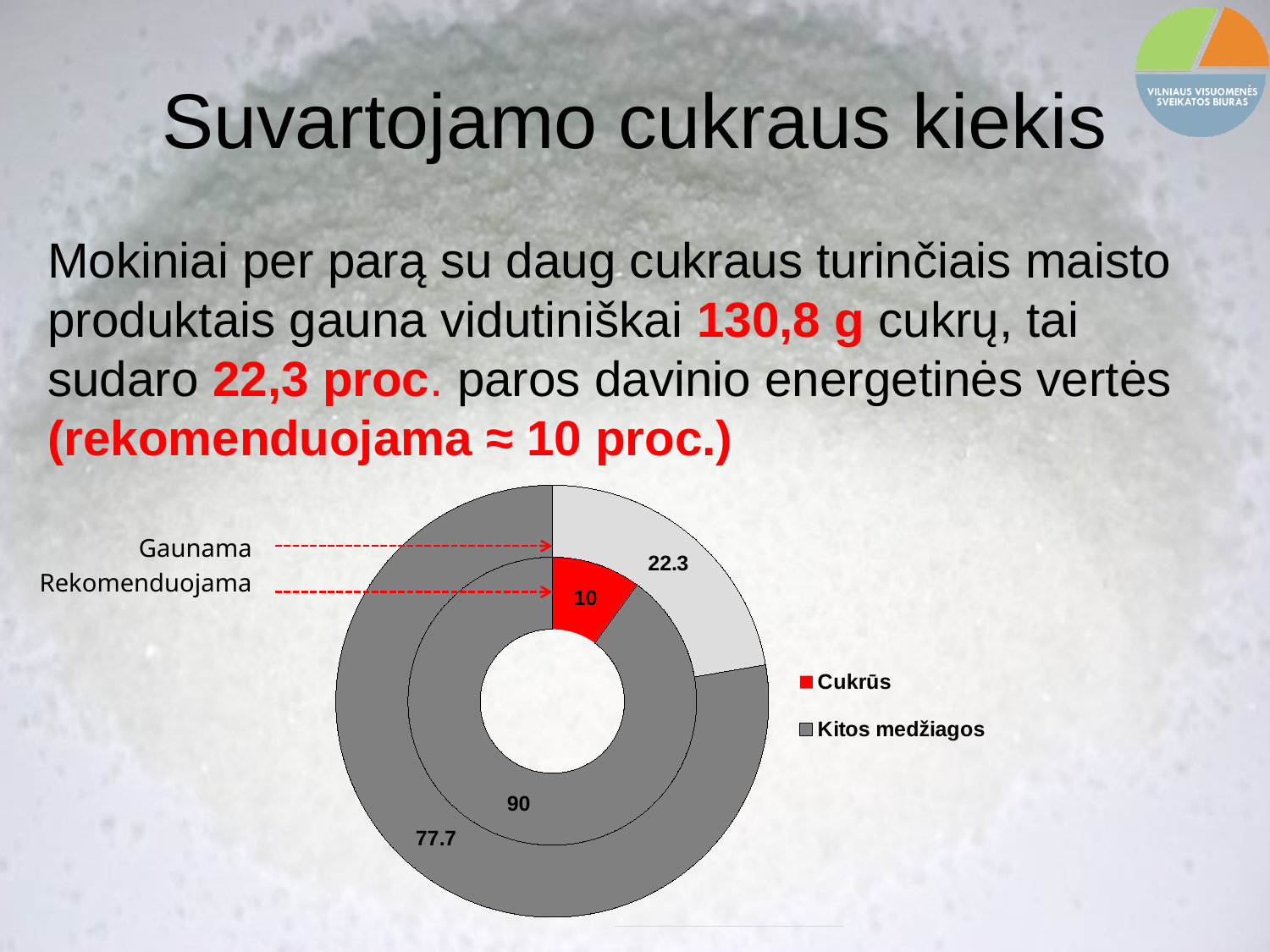
Which category has the larger value in the outer ring (Gaunama)? Kitos medžiagos What kind of chart is shown on the slide? doughnut chart What colour represents Cukrūs in the chart? red Which category has the smaller value in the inner ring (Rekomenduojama)? Cukrūs How many entries does the chart legend list? 2 In the outer ring (Gaunama), what is the value for Kitos medžiagos? 77.7 What is the difference between the Cukrūs value in the Gaunama ring and the Cukrūs value in the Rekomenduojama ring? 12.3 Which ring of the doughnut chart is labelled Rekomenduojama, the inner or the outer? inner In the inner ring (Rekomenduojama), what is the value for Cukrūs? 10 Is the Cukrūs value larger in the Gaunama ring or in the Rekomenduojama ring? Gaunama In the inner ring (Rekomenduojama), what is the value for Kitos medžiagos? 90 In the outer ring (Gaunama), what is the value for Cukrūs? 22.3